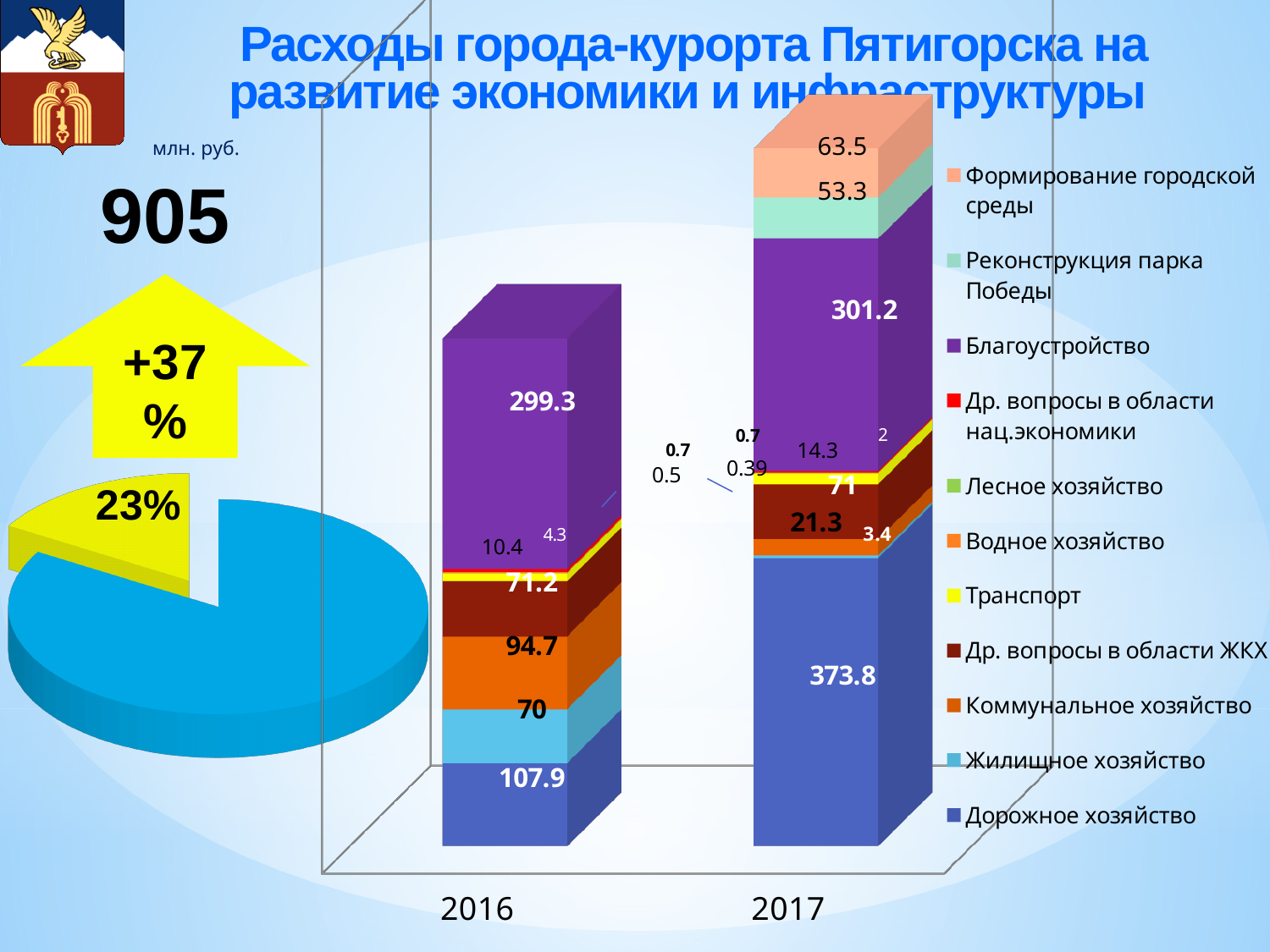
In the pie chart on the left, what share does the yellow slice represent? 23% In the stacked bar chart, what is the value for Коммунальное хозяйство in 2016? 94.7 In the stacked bar chart, which year has the larger value for Жилищное хозяйство, 2016 or 2017? 2016 In the stacked bar chart, which series has the largest segment in the 2016 bar? Благоустройство How many series does the legend of the stacked bar chart list? 11 How many years are shown on the x axis of the stacked bar chart? 2 In the stacked bar chart, what is the value for Реконструкция парка Победы in 2017? 53.3 In the stacked bar chart, which series has the largest segment in the 2017 bar? Дорожное хозяйство In the stacked bar chart, by how much did Дорожное хозяйство increase from 2016 to 2017? 265.9 In the stacked bar chart, what is the value for Дорожное хозяйство in 2017? 373.8 In the stacked bar chart, what is the value for Благоустройство in 2016? 299.3 In the stacked bar chart, what is the value for Формирование городской среды in 2017? 63.5